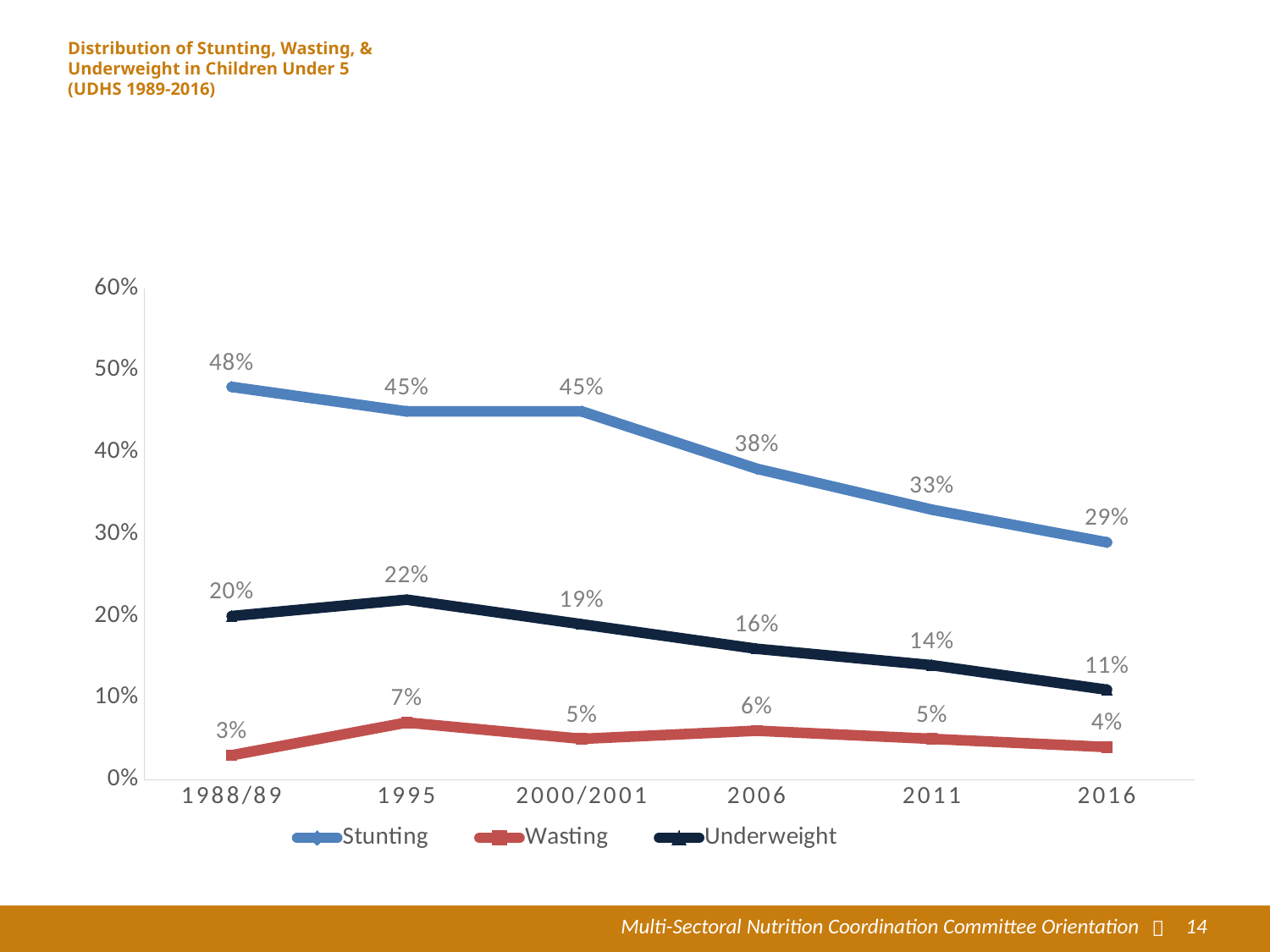
Is the Stunting value in 2011 greater or less than 40%? less In which year is the Wasting series lowest? 1988/89 What kind of chart is shown on the slide? line chart Does the Stunting series rise or fall from 1988/89 to 2016? fall What is the difference between the Stunting values in 1988/89 and 2016? 19% What is the Underweight value in 2016? 11% How many series does the legend list? 3 What is the Stunting value in 1988/89? 48% How many survey years are shown on the x axis? 6 In which year is the Underweight series highest? 1995 Which is larger in 2006, the Stunting value or the Underweight value? Stunting What is the Wasting value in 1995? 7%